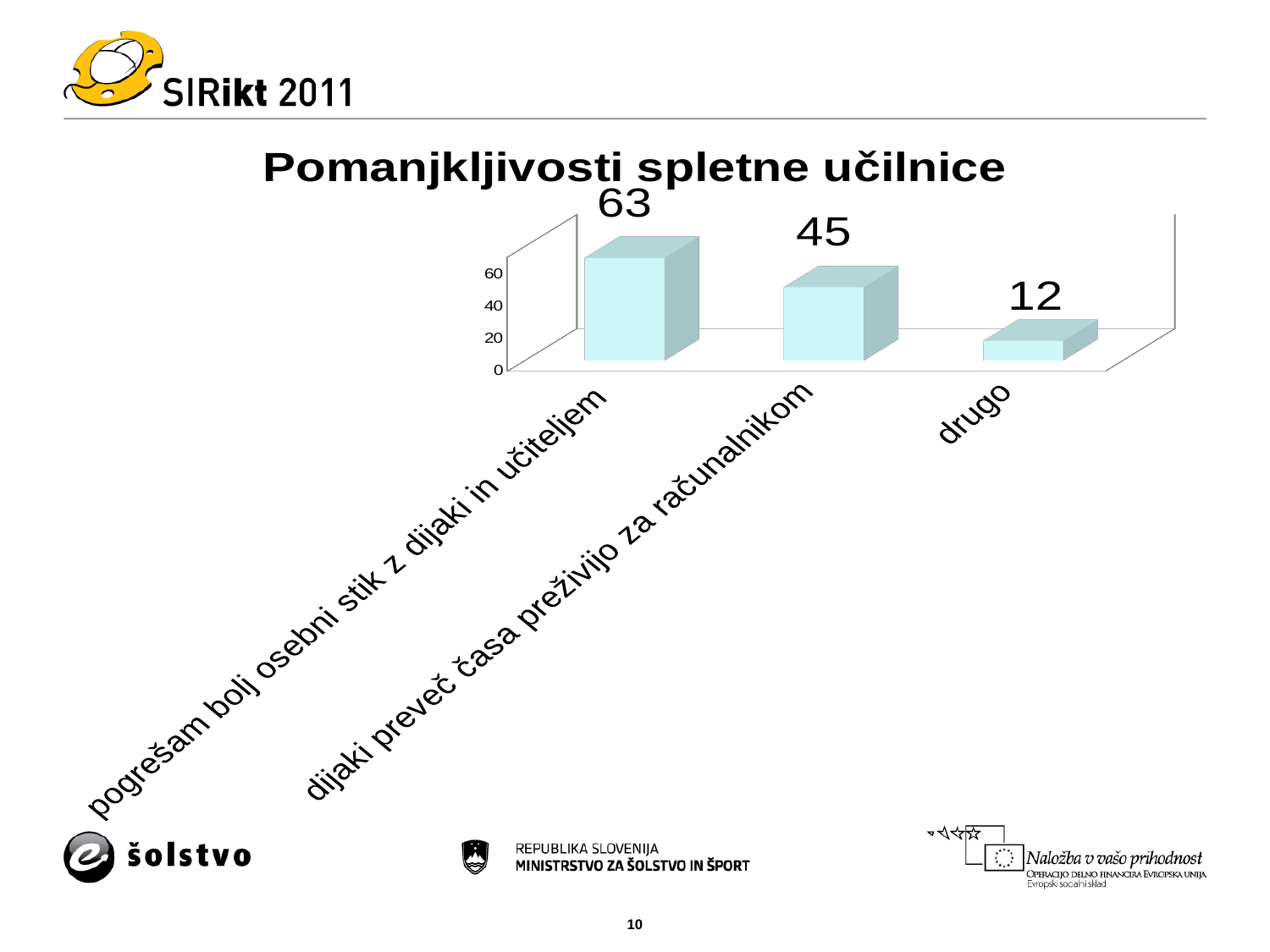
What is the value for "dijaki preveč časa preživijo za računalnikom"? 45 What is the value for "pogrešam bolj osebni stik z dijaki in učiteljem"? 63 What is the title of the chart? Pomanjkljivosti spletne učilnice What is the difference between the values for "pogrešam bolj osebni stik z dijaki in učiteljem" and "dijaki preveč časa preživijo za računalnikom"? 18 What is the value for "drugo"? 12 Which category has the lowest value? drugo What kind of chart is shown on the slide? bar chart Is the value for "drugo" greater or less than 20? less Which is larger, the value for "dijaki preveč časa preživijo za računalnikom" or the value for "drugo"? dijaki preveč časa preživijo za računalnikom How many categories are shown in the chart? 3 Which category has the highest value? pogrešam bolj osebni stik z dijaki in učiteljem What is the difference between the values for "dijaki preveč časa preživijo za računalnikom" and "drugo"? 33